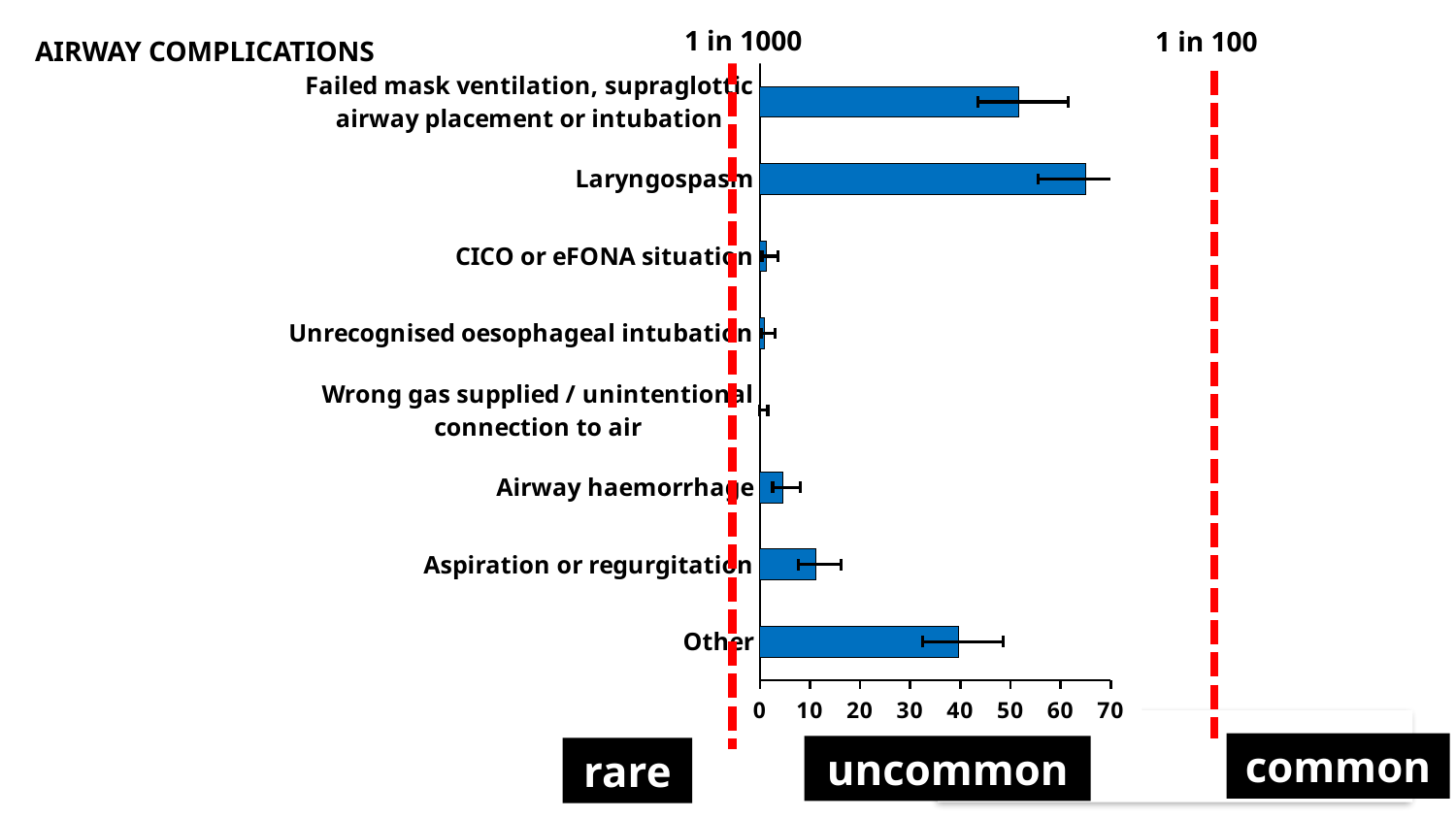
Which complication has the longest bar? Laryngospasm Is the value for Laryngospasm greater or less than 60? greater Is the value for Other greater or less than 50? less Is the value for Failed mask ventilation, supraglottic airway placement or intubation greater or less than 40? greater What kind of chart is shown on the slide? bar chart What frequency label is shown at the left red dashed line? 1 in 1000 Which bar is longer: Other or Aspiration or regurgitation? Other Which bar is longer: Laryngospasm or Failed mask ventilation, supraglottic airway placement or intubation? Laryngospasm What is the title of the chart? AIRWAY COMPLICATIONS How many complication categories are plotted on the chart? 8